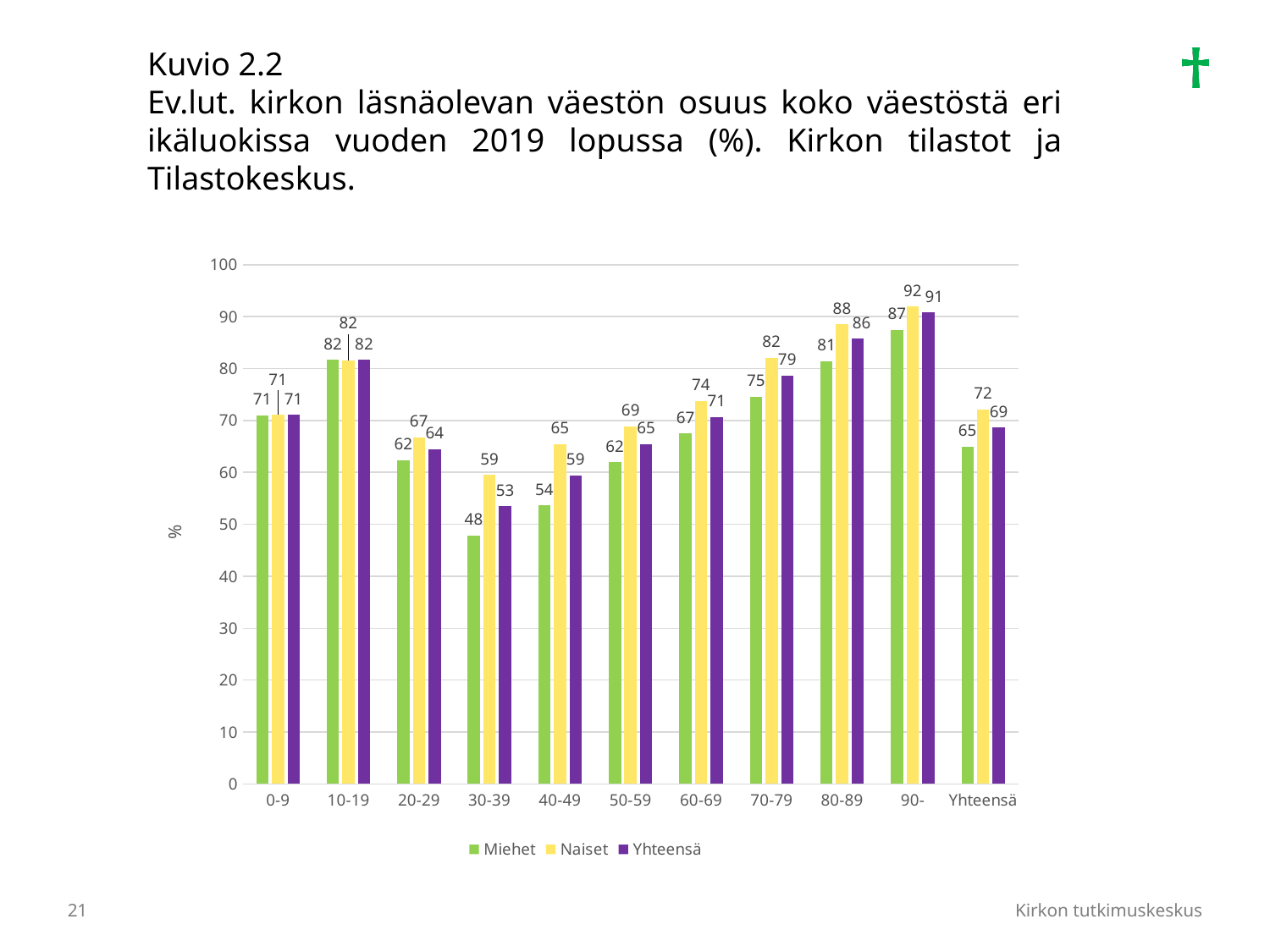
How many categories are shown on the x axis? 11 Which age group has the lowest value for Miehet? 30-39 What kind of chart is shown on the slide? Bar chart What is the value for Naiset in the 90- age group? 92 Which series is shown in purple in the legend? Yhteensä What is the difference between the Naiset and Miehet values in the 40-49 age group? 11 What is the value for Miehet in the 30-39 age group? 48 Which age group has the highest value for Naiset? 90- What is the value for Yhteensä in the 80-89 age group? 86 What is the value for Naiset in the Yhteensä category? 72 How many series does the legend list? 3 Which is larger in the 70-79 age group, the value for Miehet or for Naiset? Naiset